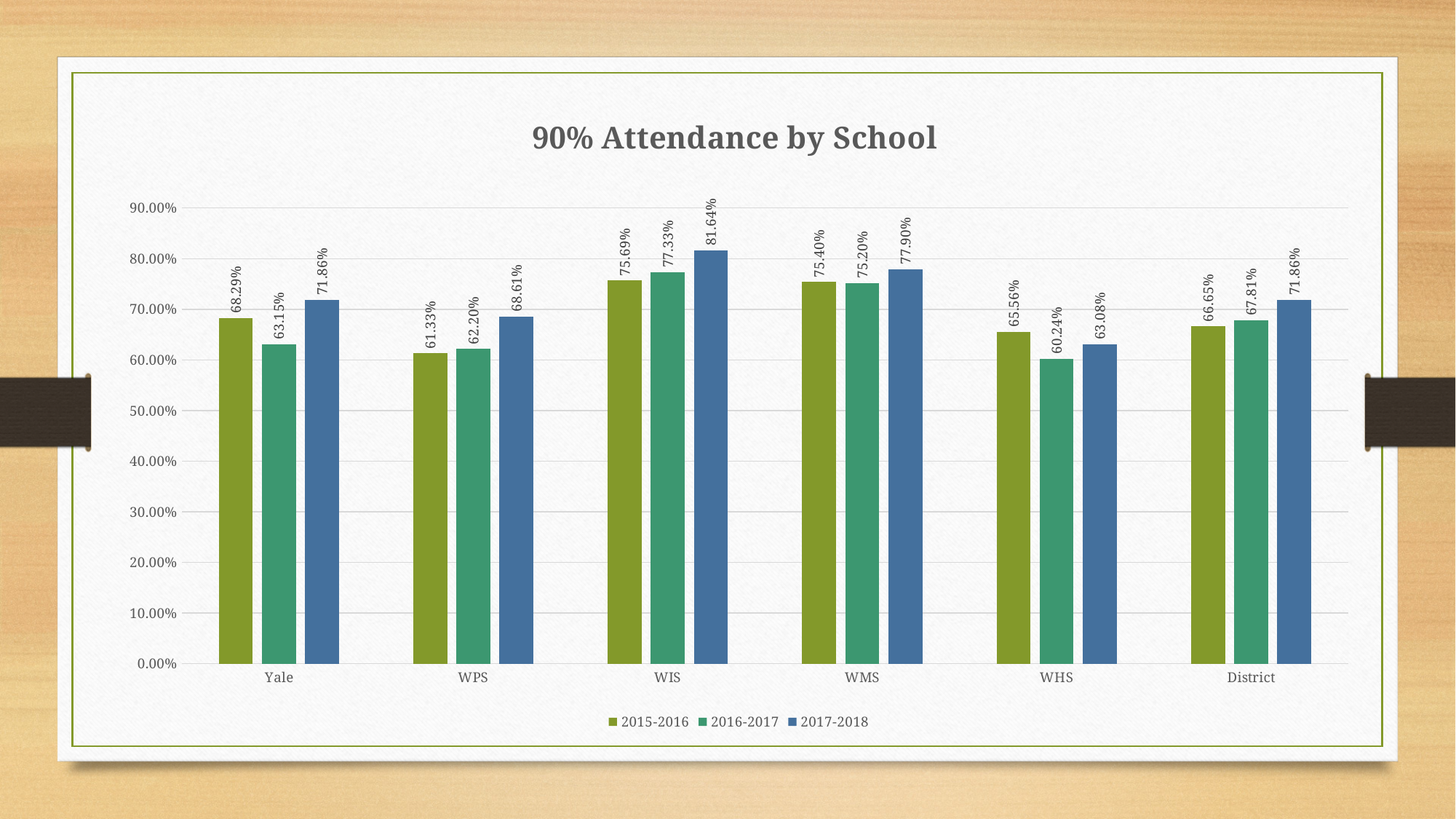
What is the 2017-2018 value for WIS? 81.64% Which category has the lowest 2015-2016 value? WPS What is the title of the chart? 90% Attendance by School How many series does the legend list? 3 How many categories are shown on the x axis? 6 What is the 2016-2017 value for WHS? 60.24% Which is larger for WMS: the 2015-2016 value or the 2016-2017 value? 2015-2016 Is the 2017-2018 value for WHS greater or less than 70.00%? less Which school has the highest 2017-2018 value? WIS What is the 2015-2016 value for Yale? 68.29% What kind of chart is shown on the slide? bar chart What is the difference between the 2017-2018 and 2015-2016 values for District? 5.21%